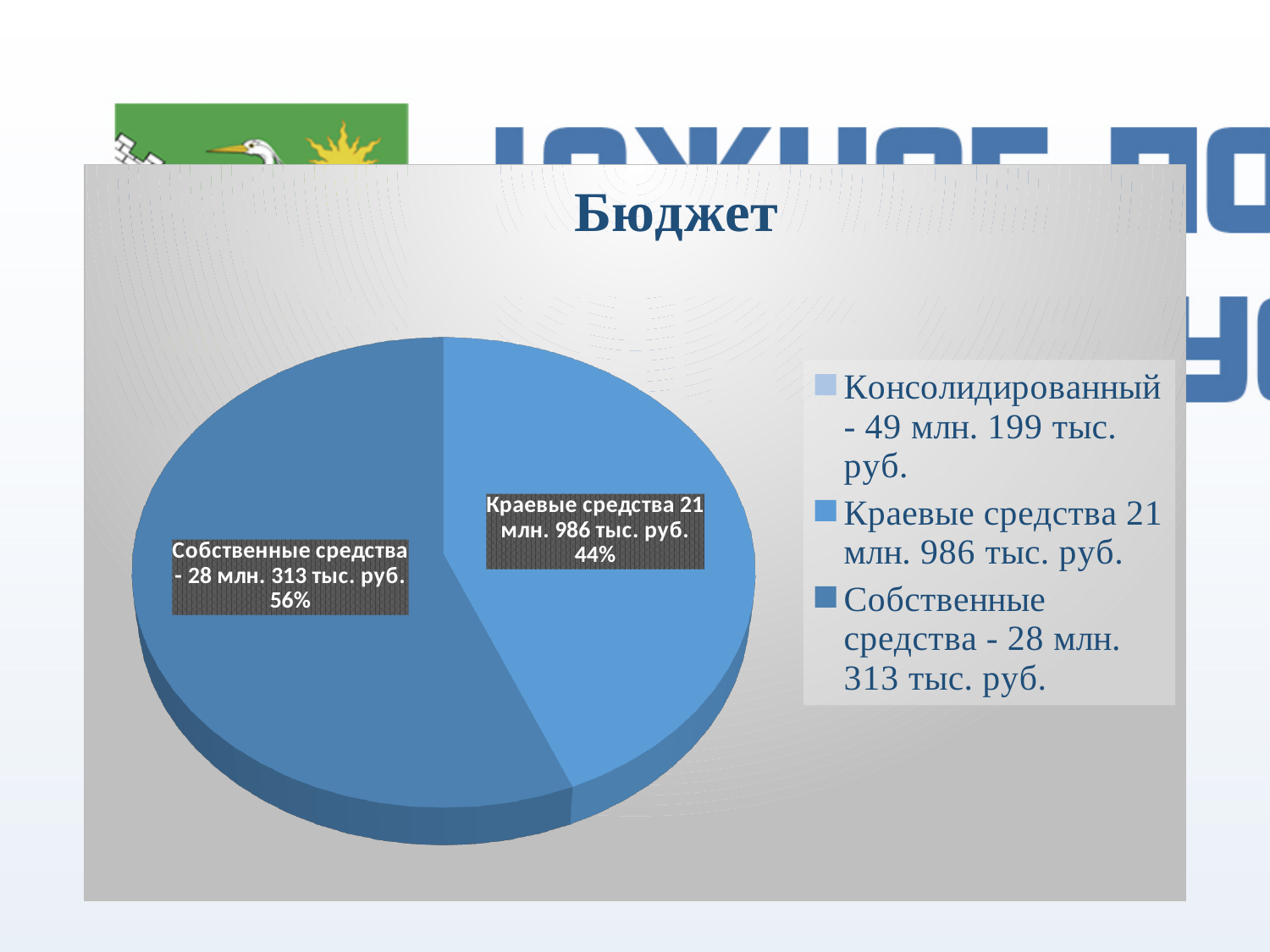
What amount does the legend give for "Консолидированный"? 49 млн. 199 тыс. руб. What amount is shown on the data label for "Краевые средства"? 21 млн. 986 тыс. руб. What is the title of the chart? Бюджет What kind of chart is shown on the slide? Pie chart What share of the pie does the slice "Собственные средства" represent? 56% By how many percentage points does the share of "Собственные средства" exceed the share of "Краевые средства"? 12 percentage points Which slice of the pie is the largest? Собственные средства Which is larger: the share for "Краевые средства" or the share for "Собственные средства"? Собственные средства Which slice of the pie is the smallest? Краевые средства What amount is shown on the data label for "Собственные средства"? 28 млн. 313 тыс. руб. How many entries does the legend list? 3 What share of the pie does the slice "Краевые средства" represent? 44%